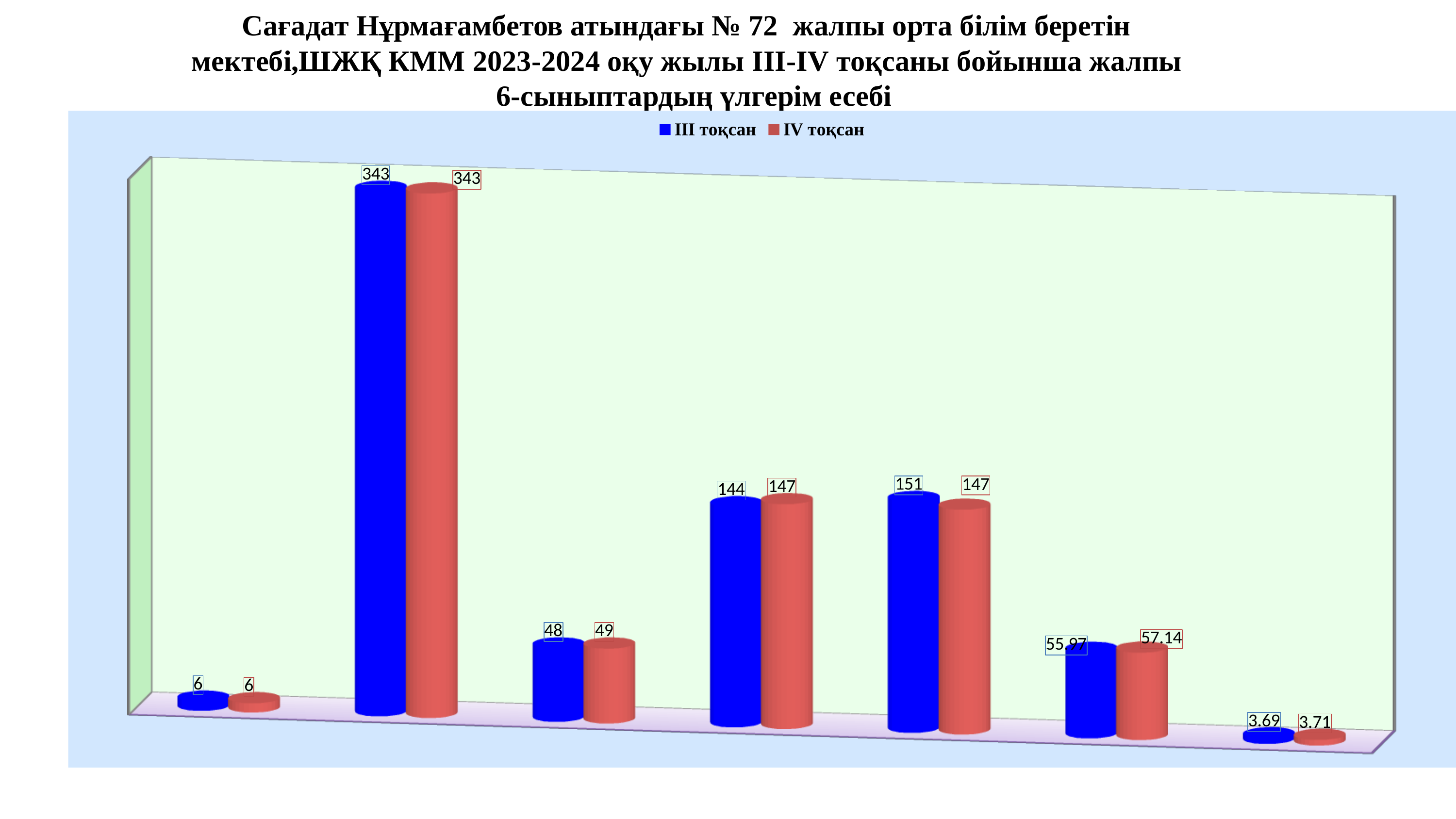
In the fifth group of bars from the left, what is the difference between the III тоқсан value and the IV тоқсан value? 4 What is the value of the IV тоқсан bar in the fourth group of bars from the left? 147 What is the value of the IV тоқсан bar in the rightmost group of bars? 3.71 What colour are the III тоқсан bars? blue What kind of chart is shown on the slide? bar chart What is the value of the III тоқсан bar in the second group of bars from the left? 343 How many groups of bars are plotted in the chart? 7 How many series does the legend list? 2 What are the two series named in the legend? III тоқсан and IV тоқсан In the third group of bars from the left, which series has the larger value, III тоқсан or IV тоқсан? IV тоқсан What is the value of the III тоқсан bar in the sixth group of bars from the left? 55.97 Which group of bars has the highest values in the chart? the second group from the left (343)